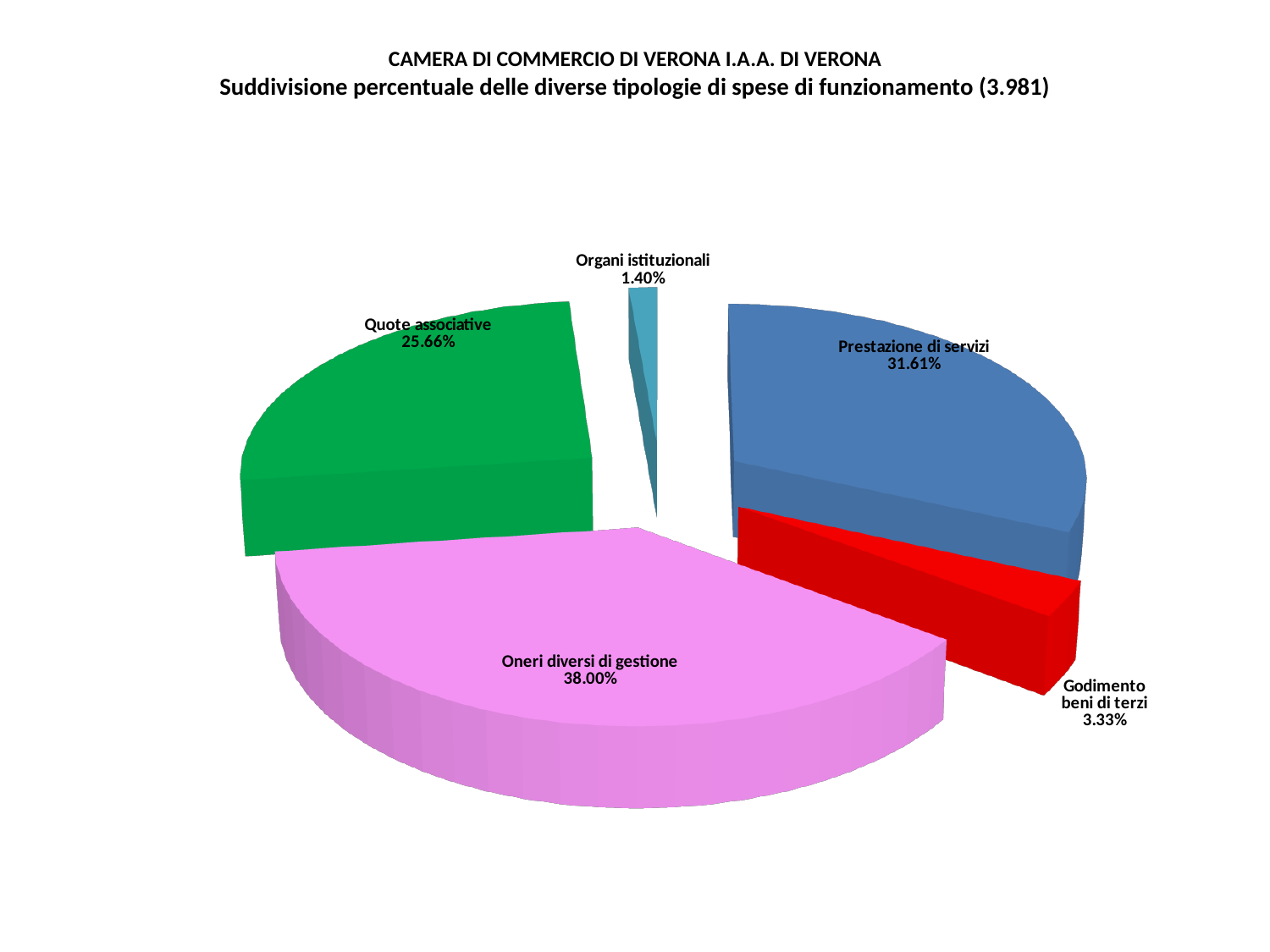
What percentage is shown for Quote associative? 25.66% What is the difference in percentage points between Oneri diversi di gestione and Prestazione di servizi? 6.39 What percentage is shown for Organi istituzionali? 1.40% What type of chart is shown on the slide? Pie chart How many categories are shown in the pie chart? 5 What number appears in parentheses in the chart title? 3.981 Which is larger, Quote associative or Prestazione di servizi? Prestazione di servizi Which category has the smallest share of the pie? Organi istituzionali What percentage is shown for Oneri diversi di gestione? 38.00% What percentage is shown for Godimento beni di terzi? 3.33% Which category has the largest share of the pie? Oneri diversi di gestione What percentage is shown for Prestazione di servizi? 31.61%